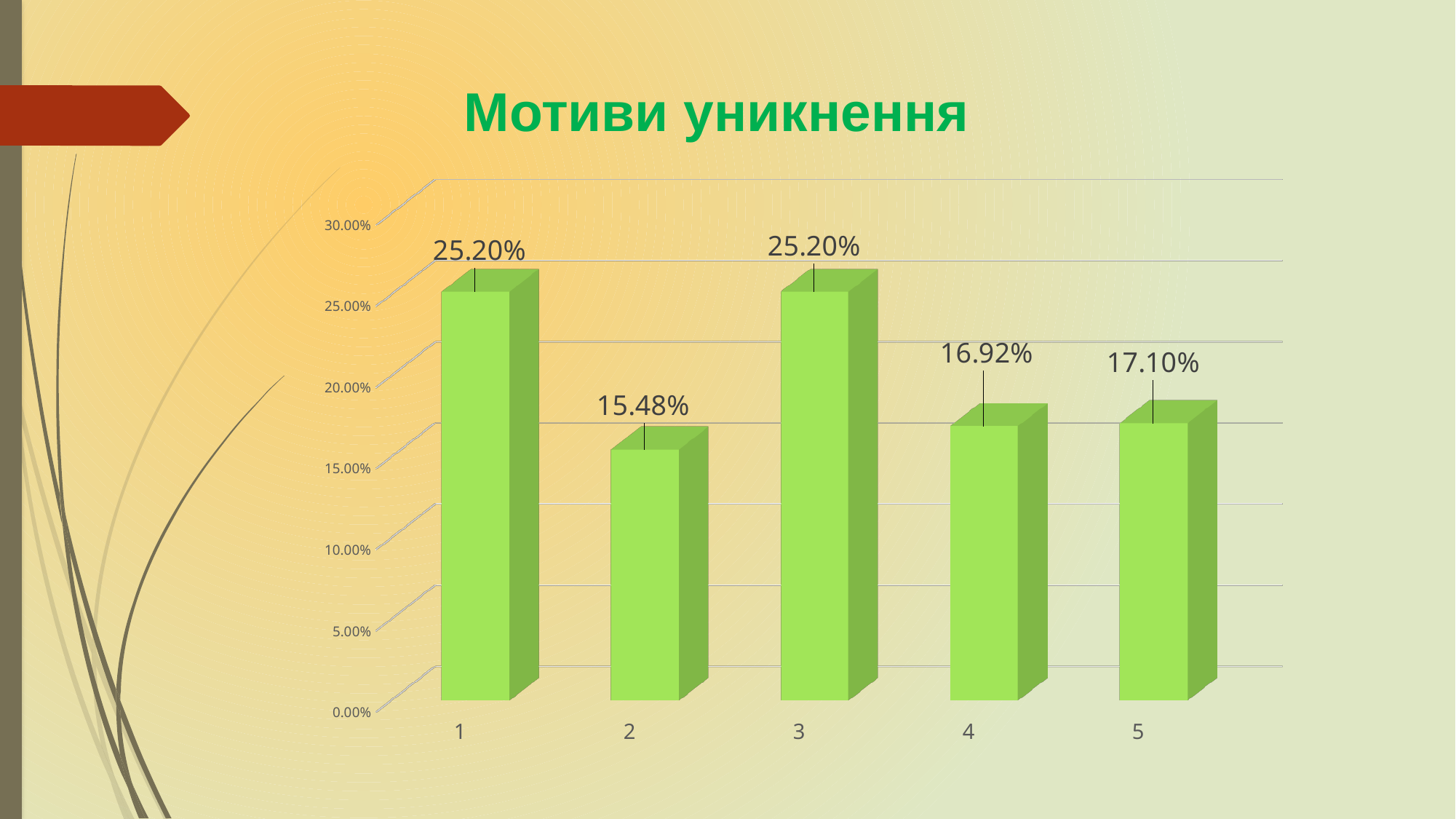
Which has the larger value, category 4 or category 5? 5 What is the value for category 5? 17.10% Which category has the lowest value? 2 Is the value for category 2 greater or less than 20.00%? less What is the value for category 4? 16.92% What is the title of the chart? Мотиви уникнення What is the value for category 2? 15.48% What is the difference between the values for category 5 and category 4? 0.18% Which two categories share the highest value? 1 and 3 What is the difference between the values for category 1 and category 2? 9.72% How many categories are shown on the x axis? 5 What is the value for category 1? 25.20%